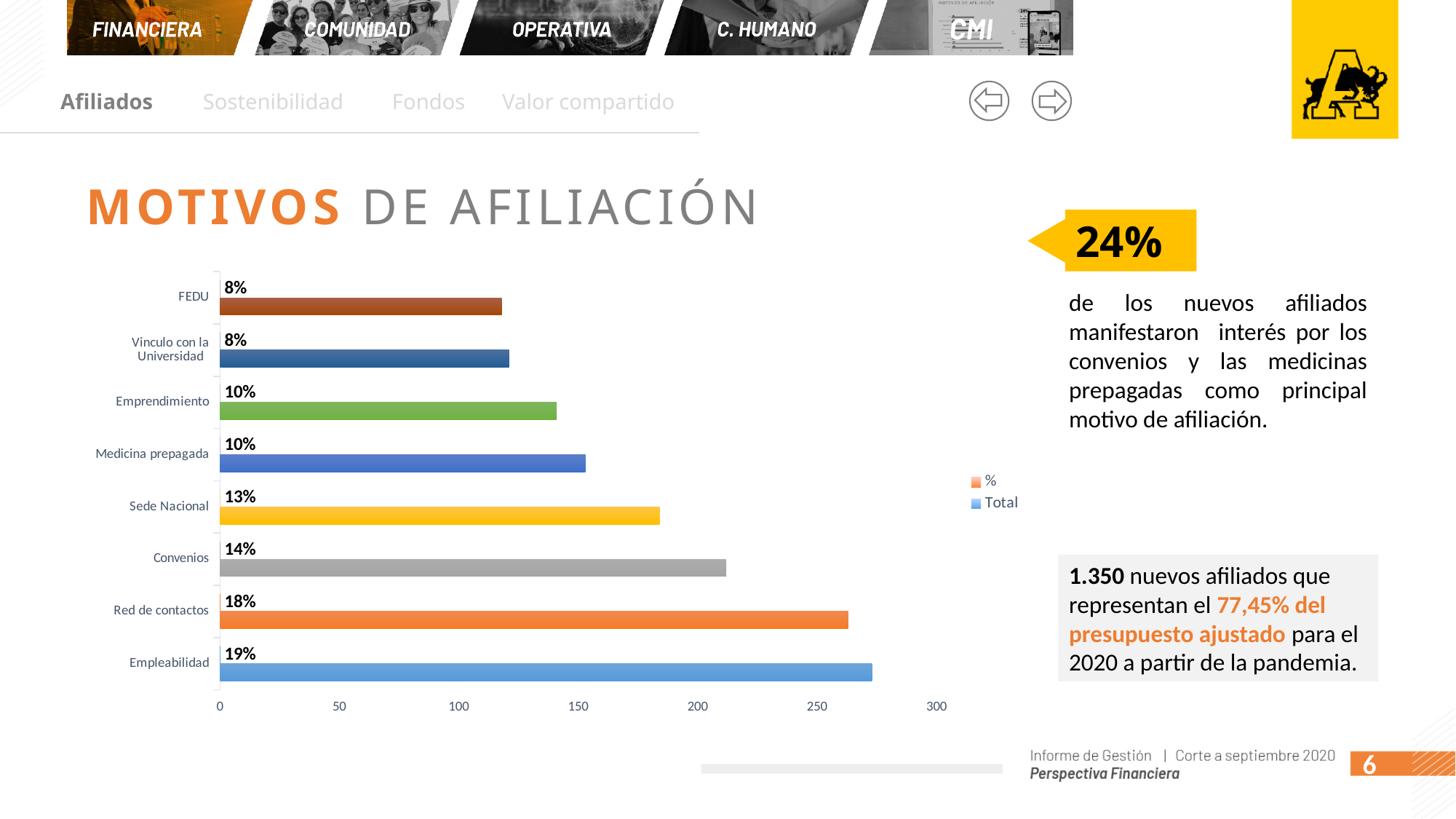
What percentage is shown for Empleabilidad? 19% What percentage is shown for Sede Nacional? 13% What is the difference in percentage points between Empleabilidad and FEDU? 11 Which category has the highest percentage? Empleabilidad Is the Total bar for Sede Nacional greater or less than 200? less What type of chart is shown on the slide? Bar chart How many series does the legend list? 2 Is the Total bar for Empleabilidad greater or less than 250? greater How many categories are shown in the chart? 8 What percentage is shown for Medicina prepagada? 10% What percentage is shown for Convenios? 14% Which has a higher percentage, Red de contactos or Convenios? Red de contactos